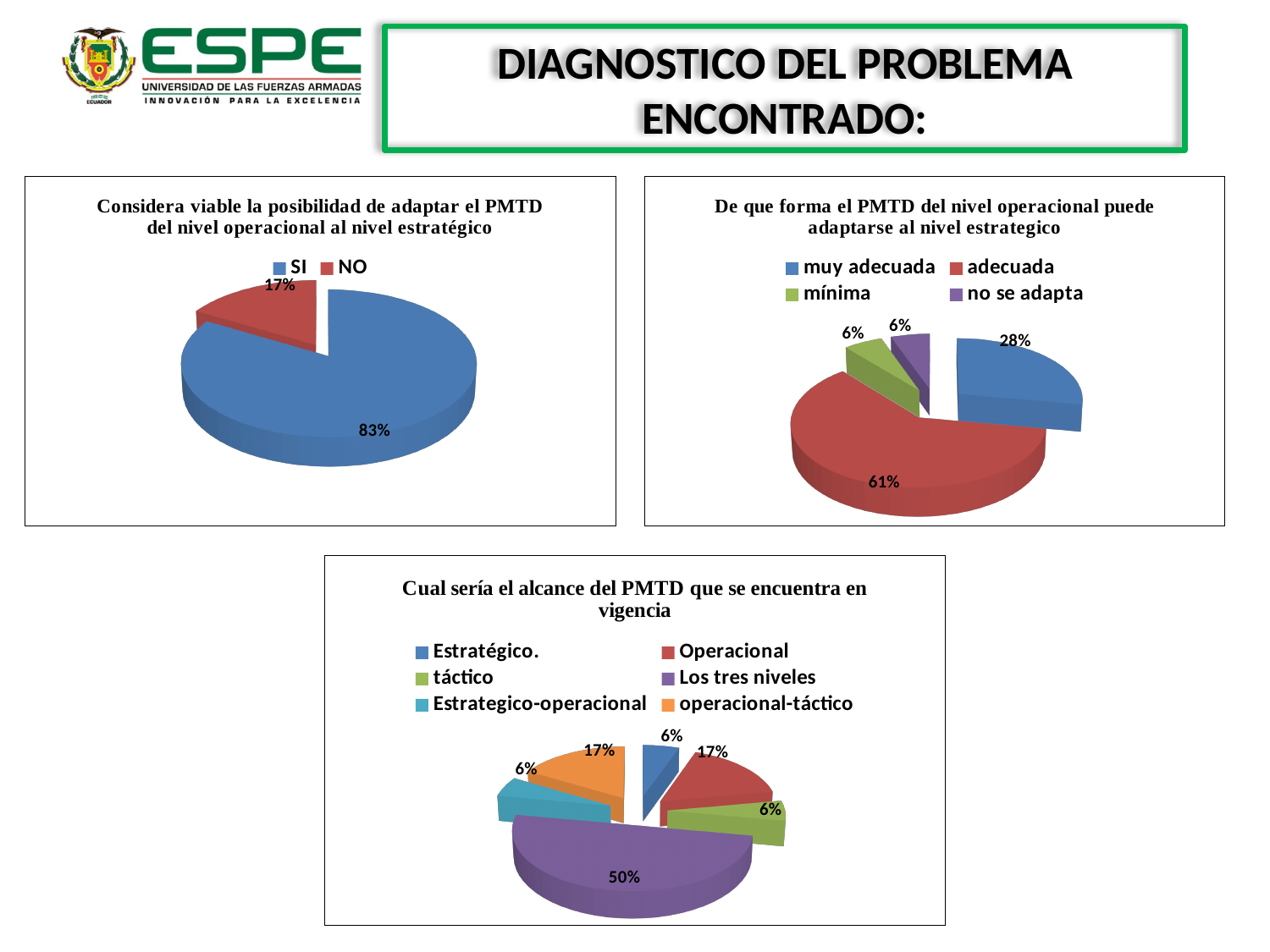
How many categories does the legend of the top-right chart (De que forma el PMTD del nivel operacional puede adaptarse...) list? 4 How many categories does the legend of the bottom chart (Cual sería el alcance del PMTD que se encuentra en vigencia) list? 6 In the top-right chart (De que forma el PMTD del nivel operacional puede adaptarse...), what percentage is shown for muy adecuada? 28% In the top-left chart (Considera viable la posibilidad de adaptar el PMTD...), what percentage is shown for NO? 17% In the top-right chart (De que forma el PMTD del nivel operacional puede adaptarse...), which category has the largest share? adecuada In the bottom chart (Cual sería el alcance del PMTD que se encuentra en vigencia), which is larger: Operacional or táctico? Operacional In the bottom chart (Cual sería el alcance del PMTD que se encuentra en vigencia), which category has the largest share? Los tres niveles In the top-left chart (Considera viable la posibilidad de adaptar el PMTD...), what percentage is shown for SI? 83% What kind of chart is the top-left chart (Considera viable la posibilidad de adaptar el PMTD...)? Pie chart In the top-left chart (Considera viable la posibilidad de adaptar el PMTD...), what is the difference between the SI and NO percentages? 66% In the top-right chart (De que forma el PMTD del nivel operacional puede adaptarse...), what percentage is shown for adecuada? 61% In the bottom chart (Cual sería el alcance del PMTD que se encuentra en vigencia), what percentage is shown for Los tres niveles? 50%